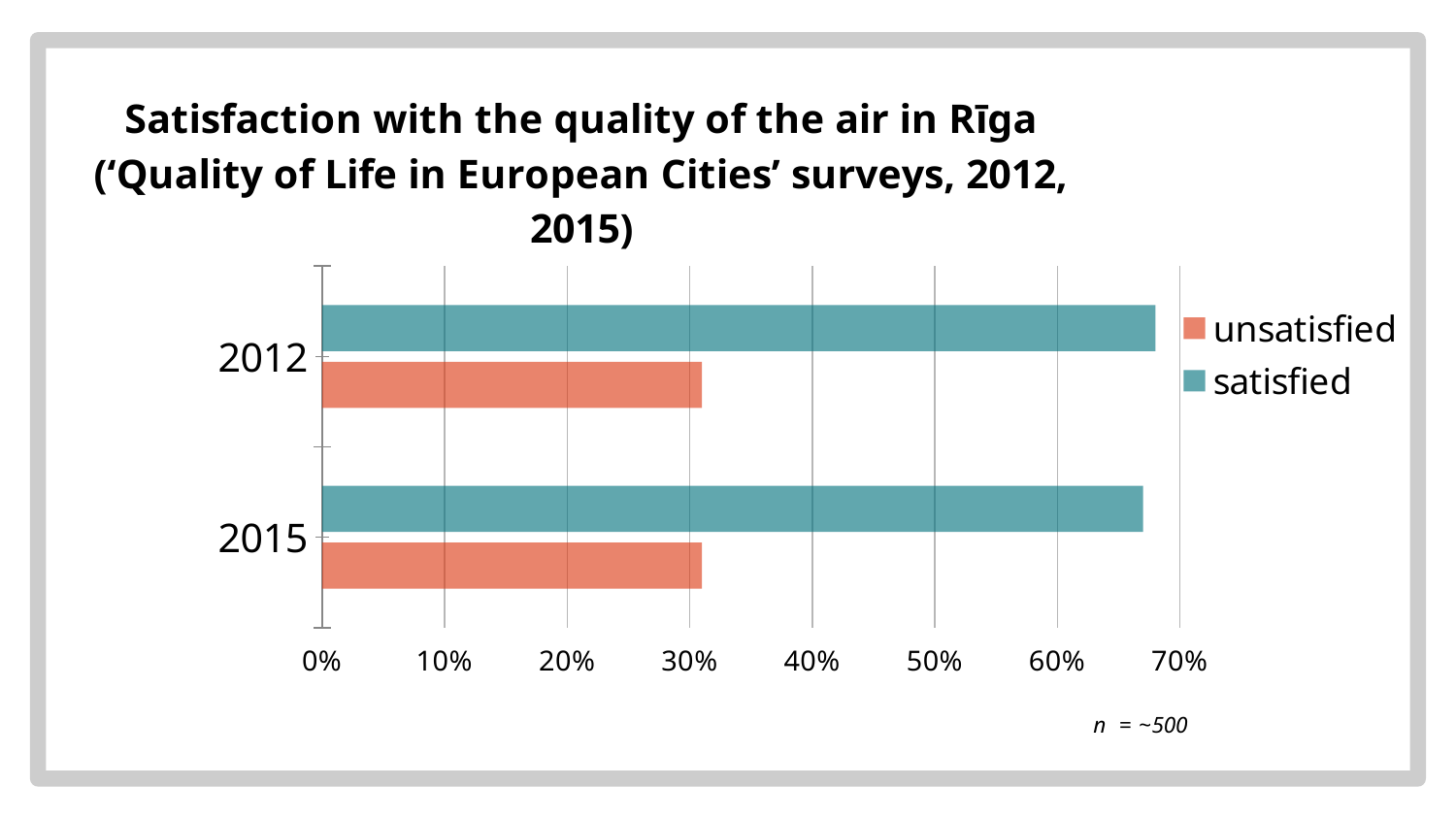
Which series is larger in 2015, satisfied or unsatisfied? satisfied How many series does the legend list? 2 Is the value for satisfied in 2012 greater or less than 70%? less Is the value for unsatisfied in 2015 greater or less than 20%? greater What is the sample size noted below the chart? n = ~500 Is the value for satisfied in 2012 greater or less than 60%? greater Which series is larger in 2012, satisfied or unsatisfied? satisfied Which colour represents the 'satisfied' series in the legend? teal (blue-green) What kind of chart is shown on the slide? bar chart How many years (categories) are shown on the chart? 2